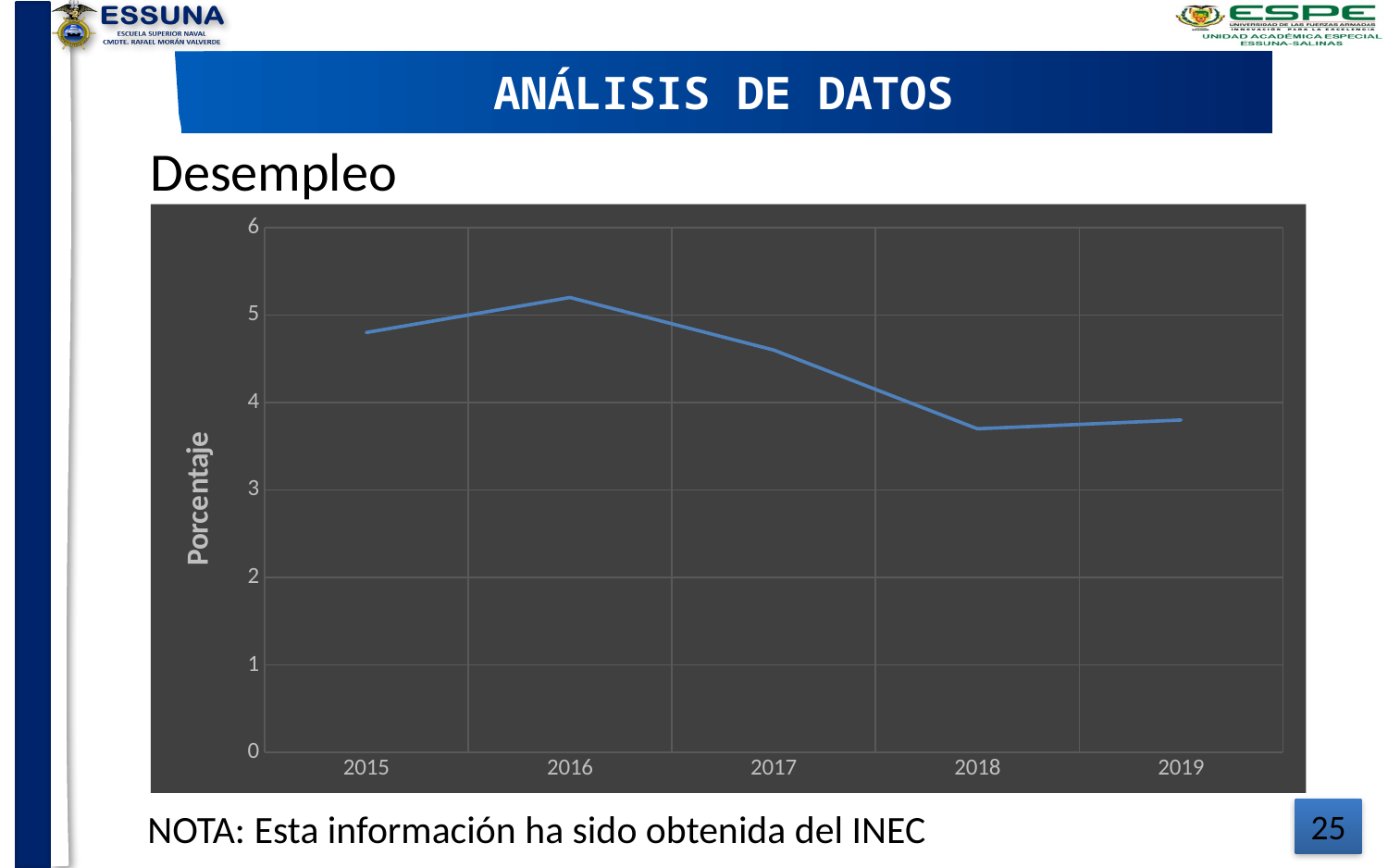
Which year has the larger value, 2015 or 2016? 2016 How many years are plotted on the x axis of the chart? 5 Is the value for 2019 greater or less than 4? less Is the value for 2017 greater or less than 4? greater Does the line rise or fall from 2016 to 2018? fall Is the value for 2016 greater or less than 5? greater What is the label on the vertical axis of the chart? Porcentaje What kind of chart is shown on the slide? line chart Which year has the larger value, 2017 or 2018? 2017 Which year has the highest unemployment percentage in the chart? 2016